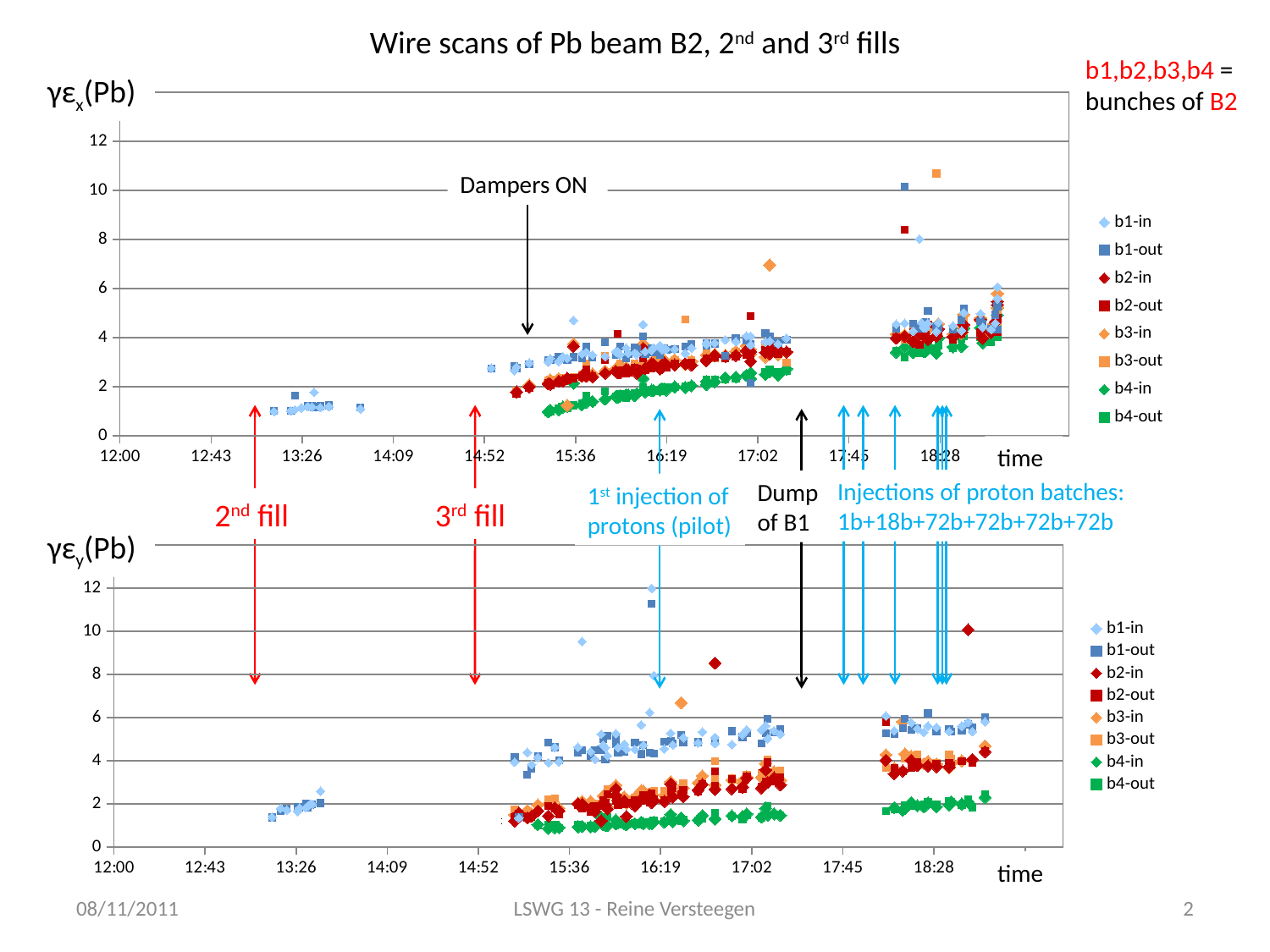
In the top chart, γεx(Pb), are the b1-in points around 13:26 greater or less than 2? less In the bottom chart, γεy(Pb), are the b4-out points around 17:02 greater or less than 2? less What is the first time label on the horizontal axis of the bottom chart, γεy(Pb)? 12:00 What kind of chart is the top chart, γεx(Pb)? scatter chart How many series does the legend of the top chart, γεx(Pb), list? 8 In the top chart, γεx(Pb), is the highest b3-out point near 18:28 greater or less than 10? greater How many series does the legend of the bottom chart, γεy(Pb), list? 8 What is the maximum value shown on the vertical axis of the top chart, γεx(Pb)? 12 In the top chart, γεx(Pb), do the b4-in values rise or fall between 15:36 and 17:02? rise In the bottom chart, γεy(Pb), around 17:02, which series has larger values: b1-out or b4-out? b1-out How many time tick labels are shown on the horizontal axis of the top chart, γεx(Pb)? 10